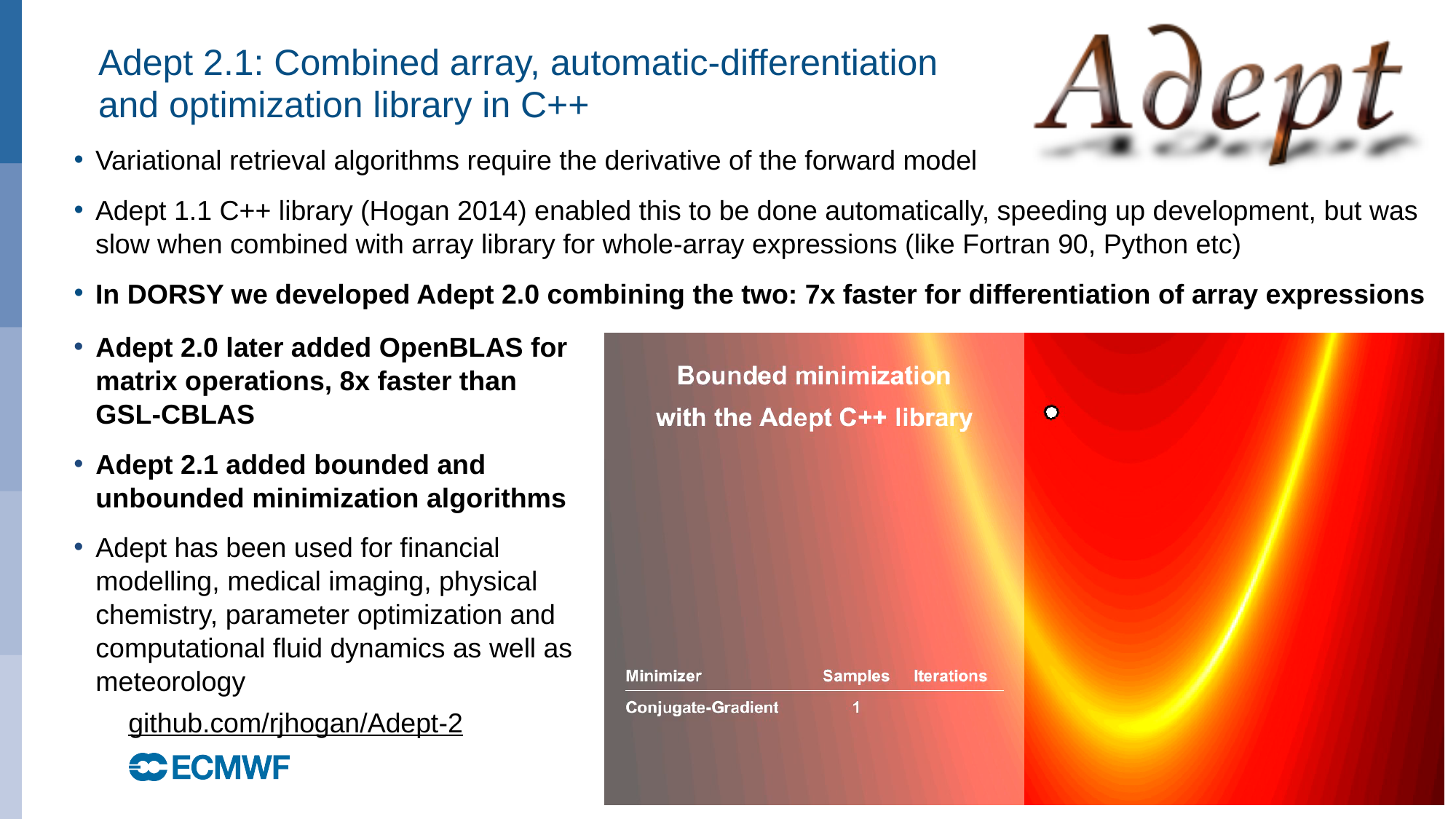
In the visualization on the right, which minimizer is listed in the table? Conjugate-Gradient What are the three column headings of the table in the visualization on the right? Minimizer, Samples, Iterations What is the title shown on the visualization image on the right of the slide? Bounded minimization with the Adept C++ library In the visualization on the right, how many samples are listed for the Conjugate-Gradient minimizer? 1